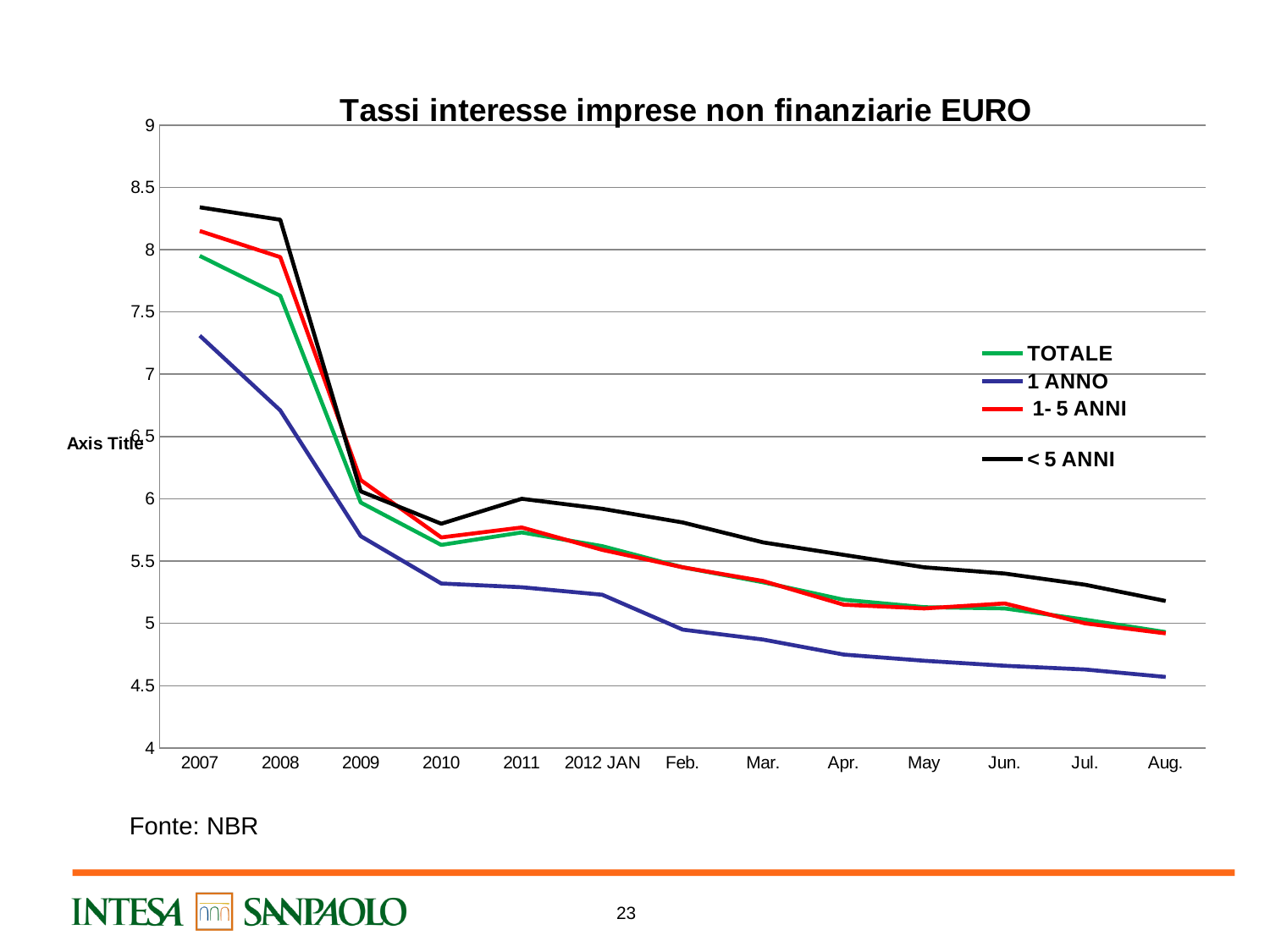
Which series has the highest value in 2007? < 5 ANNI How many series does the legend list? 4 Is the value for 1 ANNO in Aug. greater or less than 5? less Is the value for 1 ANNO in 2007 greater or less than 7? greater How many points are there along the x axis? 13 Do the values of the 1 ANNO series rise or fall from 2007 to Aug.? fall Which series has the lowest value in 2007? 1 ANNO What kind of chart is shown on the slide? line chart Is the value for < 5 ANNI in 2007 greater or less than 8? greater What is the title of the chart? Tassi interesse imprese non finanziarie EURO In Aug., which is larger: the value for < 5 ANNI or the value for 1 ANNO? < 5 ANNI